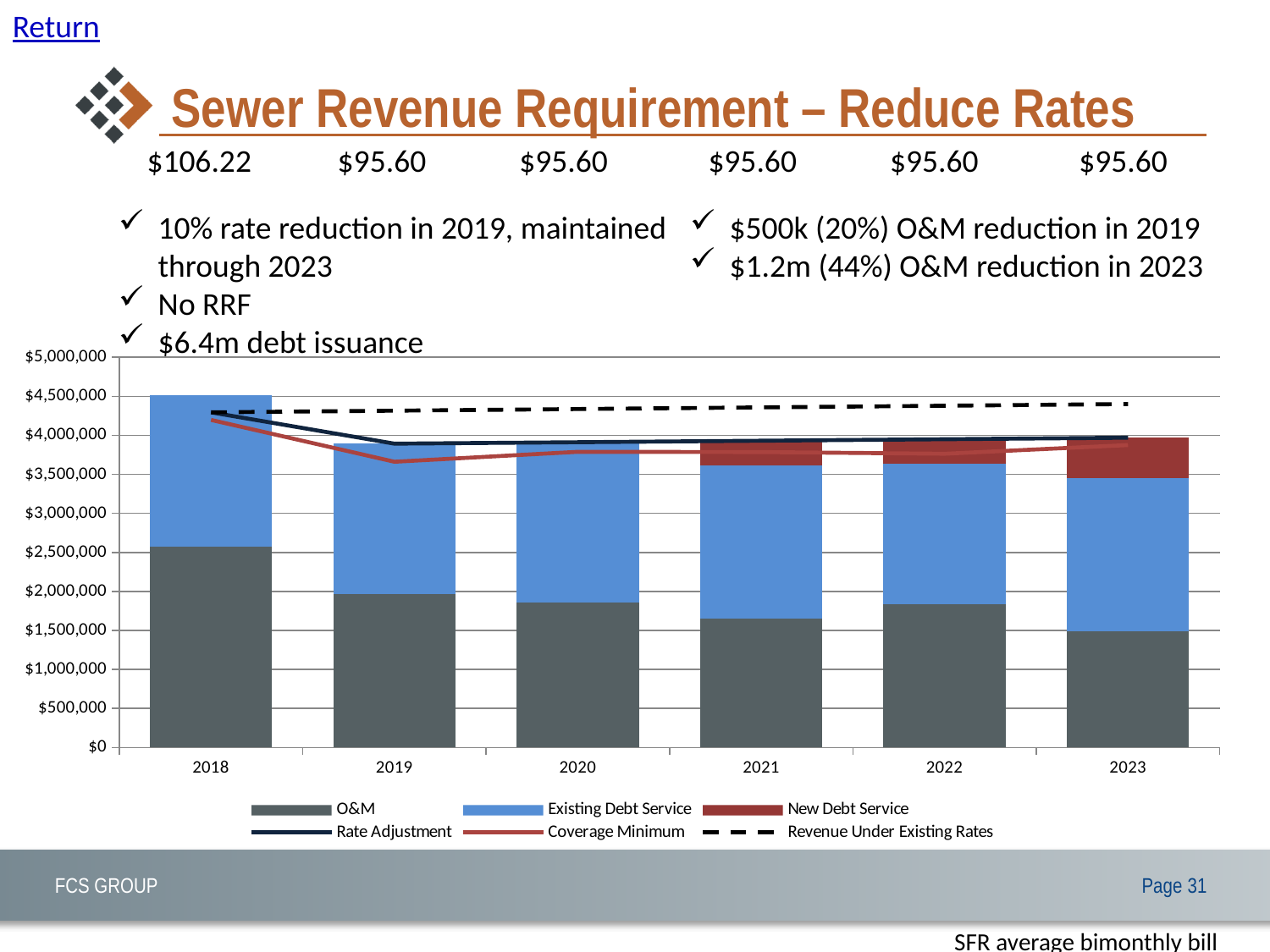
What kind of chart is shown on the slide? combination bar and line chart In which year is the O&M segment the shortest? 2023 In which year is the O&M segment the tallest? 2018 Which is larger, the O&M value for 2018 or the O&M value for 2019? 2018 How many years are shown on the x axis of the chart? 6 Is the Revenue Under Existing Rates line greater or less than $4,000,000 in 2023? greater Is the O&M value for 2018 greater or less than $2,000,000? greater Which year has the tallest stacked bar overall? 2018 How many series does the chart legend list? 6 Which legend series is drawn as a dashed line? Revenue Under Existing Rates Is the total stacked bar for 2019 greater or less than $4,000,000? less In how many years does the New Debt Service segment appear in the stacked bars? 3